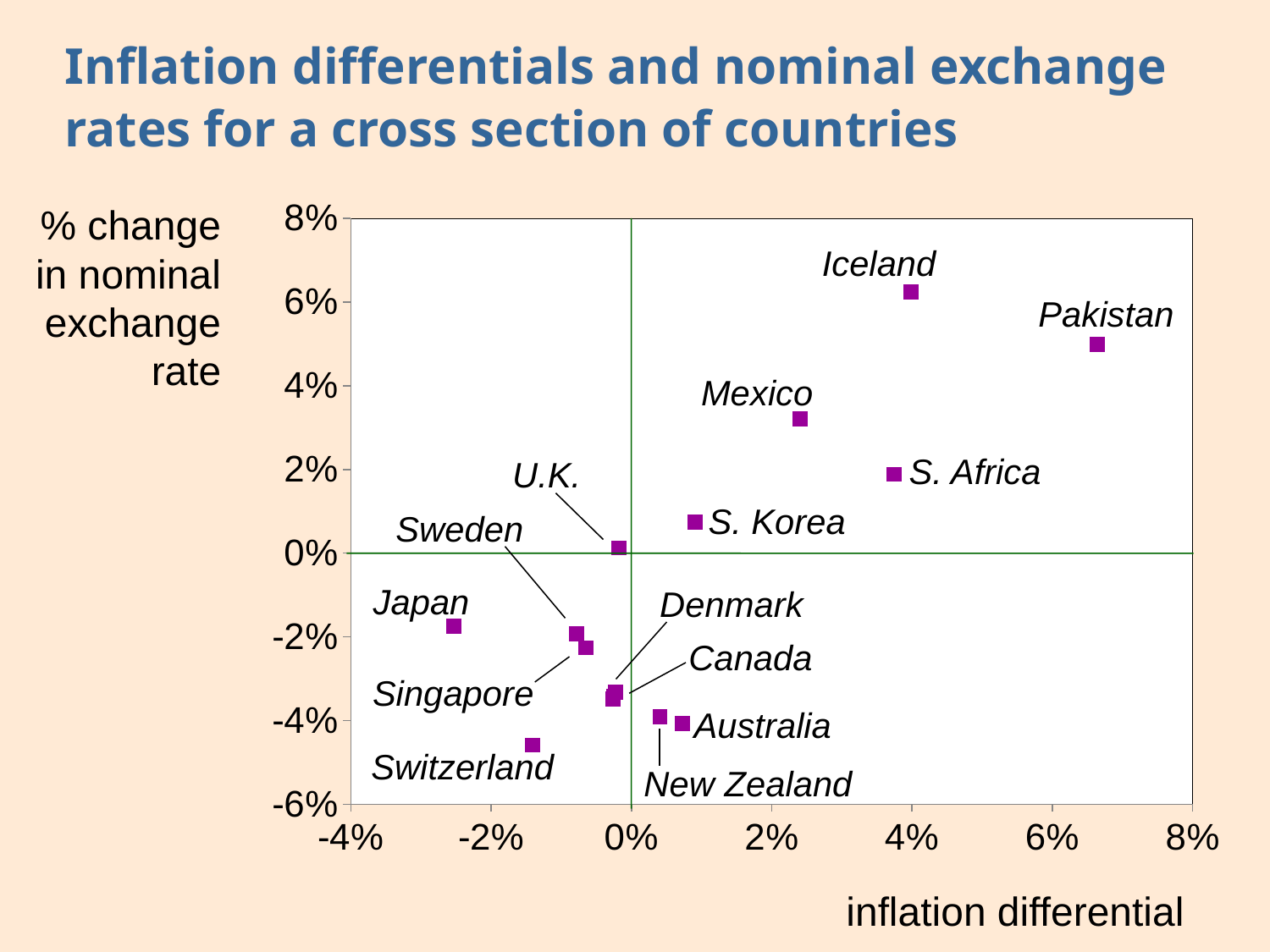
How many countries are plotted on the chart? 14 Which country has the highest % change in nominal exchange rate? Iceland Is the % change in nominal exchange rate for Iceland greater or less than 6%? greater What kind of chart is shown on the slide? Scatter chart Is the inflation differential for Pakistan greater or less than 6%? greater Which has a higher % change in nominal exchange rate, Mexico or S. Africa? Mexico What is the label of the horizontal axis? inflation differential Which country has the smallest (most negative) inflation differential? Japan Which has a larger inflation differential, Japan or Switzerland? Switzerland Which country has the largest inflation differential? Pakistan Which country has the lowest % change in nominal exchange rate? Switzerland Is the % change in nominal exchange rate for Switzerland greater or less than -4%? less